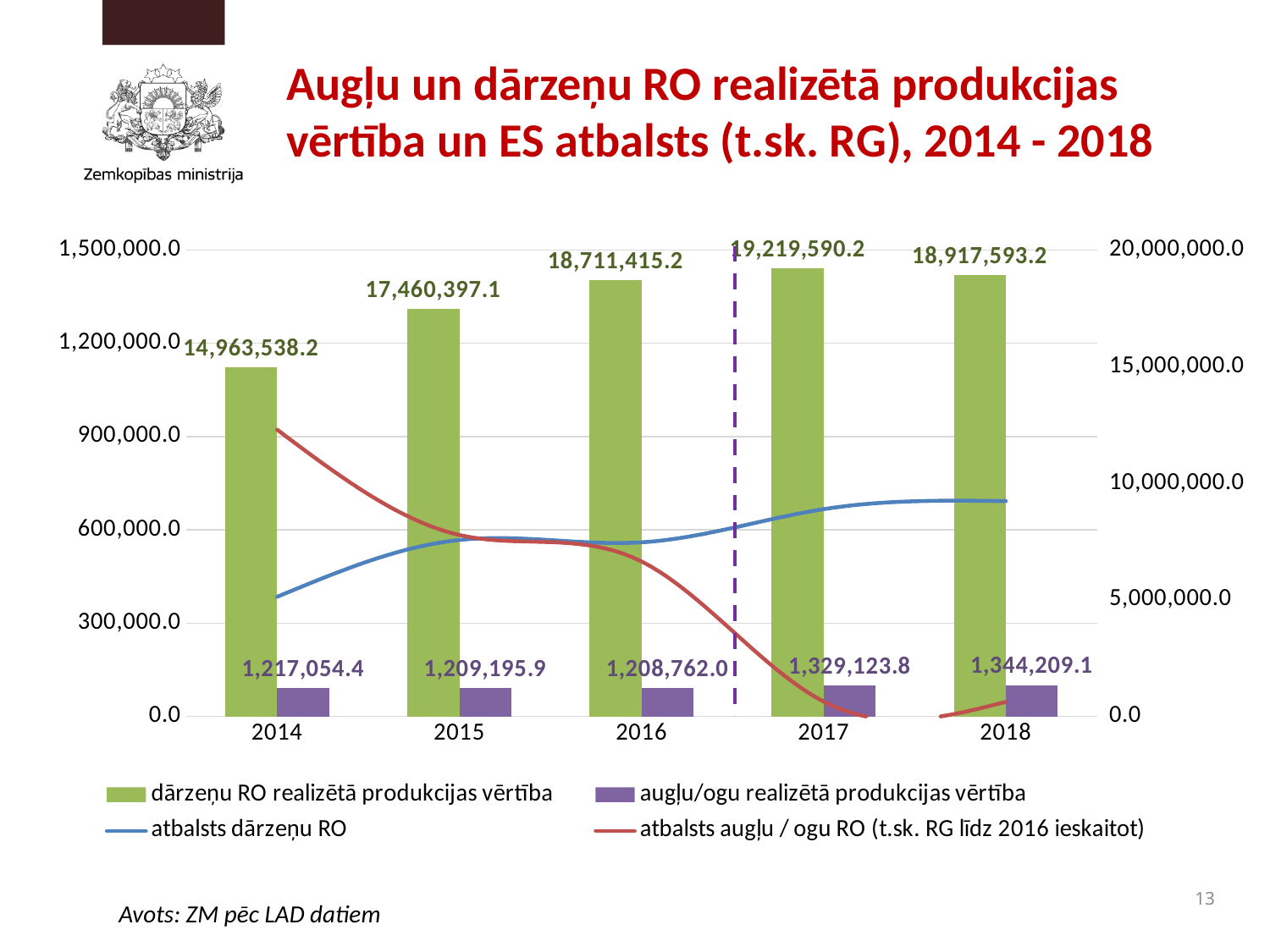
How many series does the legend list? 4 In which year is augļu/ogu realizētā produkcijas vērtība highest? 2018 What is the value of augļu/ogu realizētā produkcijas vērtība in 2017? 1,329,123.8 Is the value of atbalsts dārzeņu RO in 2014 greater or less than 600,000.0? less What kind of chart is this? Combination bar and line chart What is the value of dārzeņu RO realizētā produkcijas vērtība in 2016? 18,711,415.2 How many years are shown on the x axis? 5 Which is larger: augļu/ogu realizētā produkcijas vērtība in 2014 or in 2015? 2014 In which year is dārzeņu RO realizētā produkcijas vērtība highest? 2017 What is the difference between dārzeņu RO realizētā produkcijas vērtība in 2017 and 2018? 301,997.0 In which year is dārzeņu RO realizētā produkcijas vērtība lowest? 2014 Is the value of atbalsts augļu / ogu RO in 2014 greater or less than 600,000.0? greater